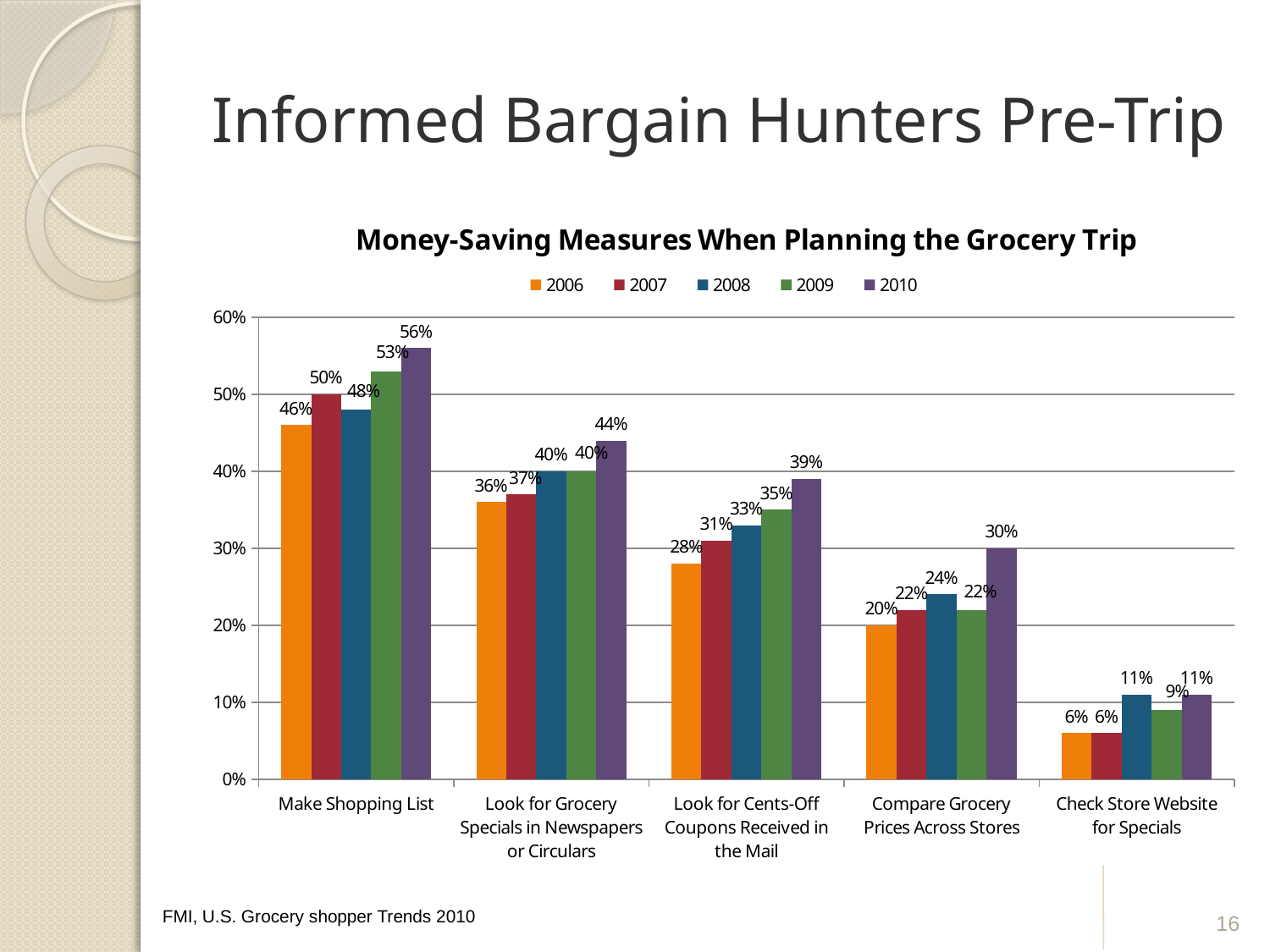
Which is larger for Look for Grocery Specials in Newspapers or Circulars: the 2007 value or the 2010 value? 2010 What is the difference between the 2010 and 2006 values for Make Shopping List? 10% Which category has the lowest 2006 value? Check Store Website for Specials What kind of chart is shown on the slide? Bar chart What is the 2006 value for Look for Cents-Off Coupons Received in the Mail? 28% What is the 2009 value for Check Store Website for Specials? 9% How many categories are shown on the x axis? 5 What is the 2008 value for Compare Grocery Prices Across Stores? 24% What is the 2010 value for Make Shopping List? 56% Which category has the highest 2010 value? Make Shopping List How many series does the legend list? 5 What is the title of the chart? Money-Saving Measures When Planning the Grocery Trip